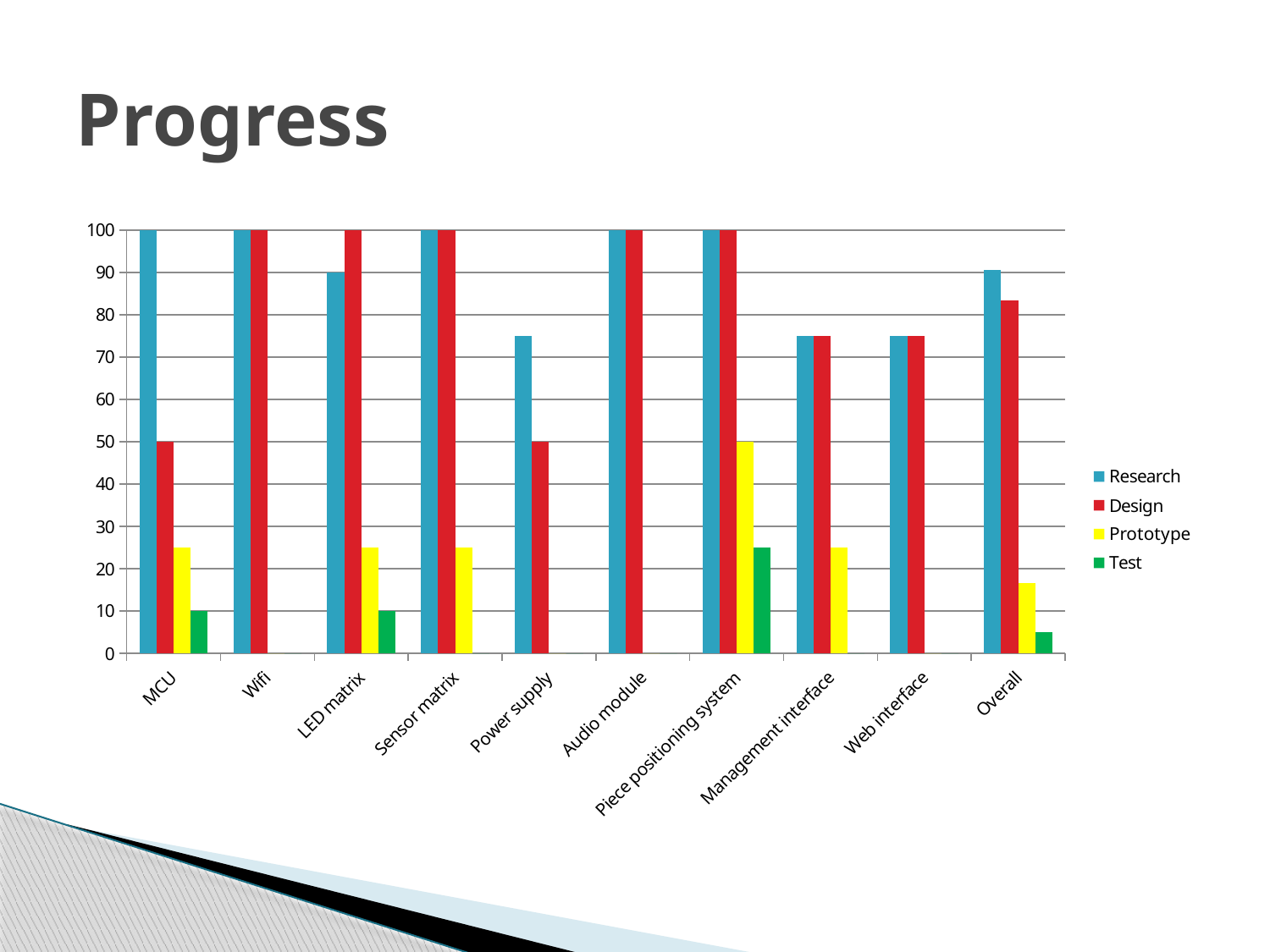
What type of chart is shown on the slide? bar chart What is the Research value for LED matrix? 90 What is the Test value for LED matrix? 10 What is the Design value for MCU? 50 What is the difference between the Research and Design values for MCU? 50 What is the Design value for Power supply? 50 Which is larger for MCU, the Research value or the Design value? Research How many series does the legend list? 4 Is the Research value for Power supply greater or less than 70? greater How many categories are shown on the x axis? 10 What is the Prototype value for Piece positioning system? 50 Is the Prototype value for Management interface greater or less than 30? less